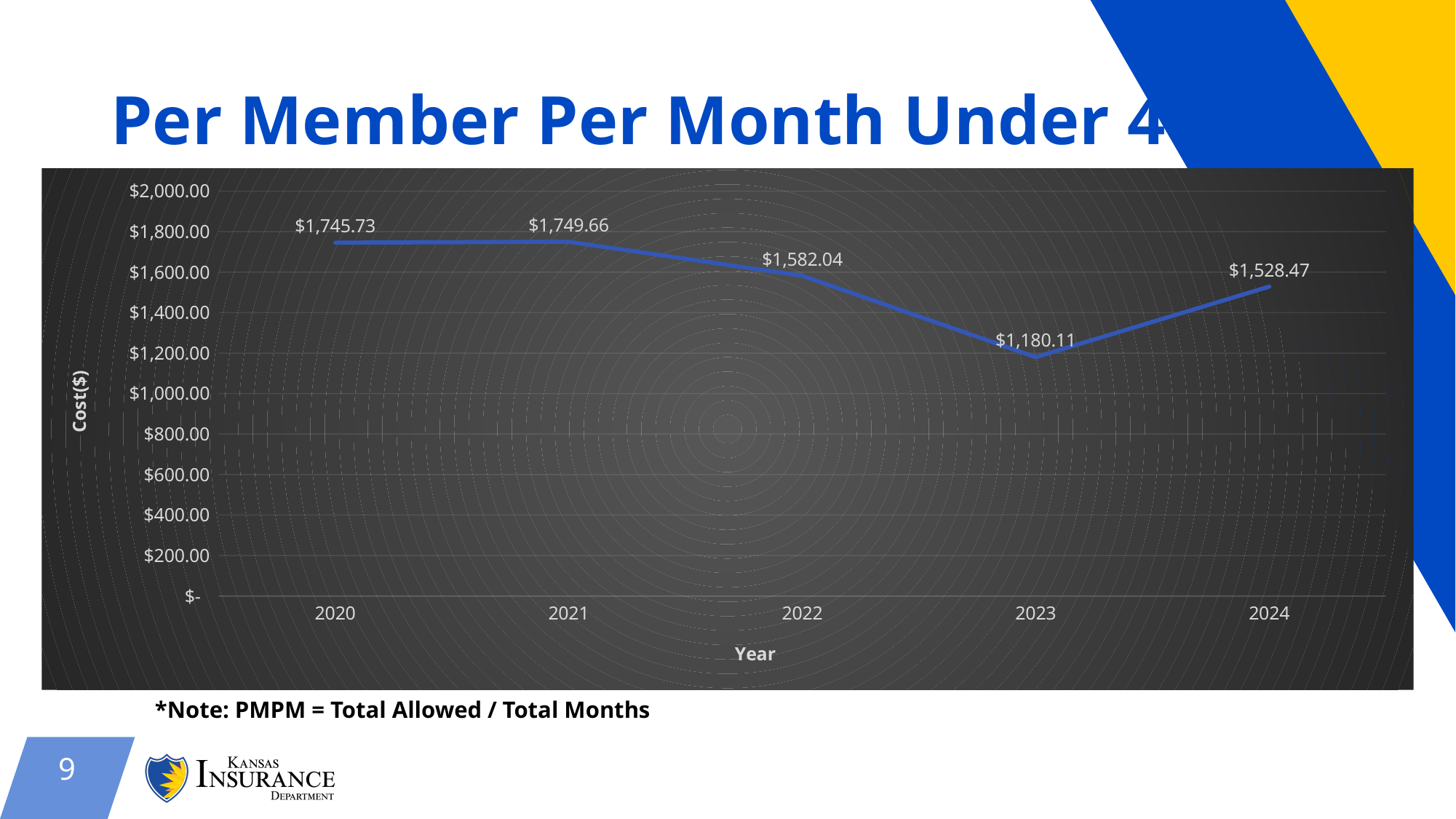
Which year has the lowest value? 2023 What is the value for 2020? $1,745.73 What is the value for 2023? $1,180.11 What kind of chart is shown on the slide? Line chart Do the values rise or fall from 2021 to 2023? Fall Which is larger, the value for 2022 or the value for 2024? 2022 What is the difference between the values for 2022 and 2023? $401.93 Which year has the highest value? 2021 What is the label of the vertical axis? Cost($) How many years are plotted on the chart? 5 What is the difference between the values for 2024 and 2023? $348.36 What is the value for 2024? $1,528.47